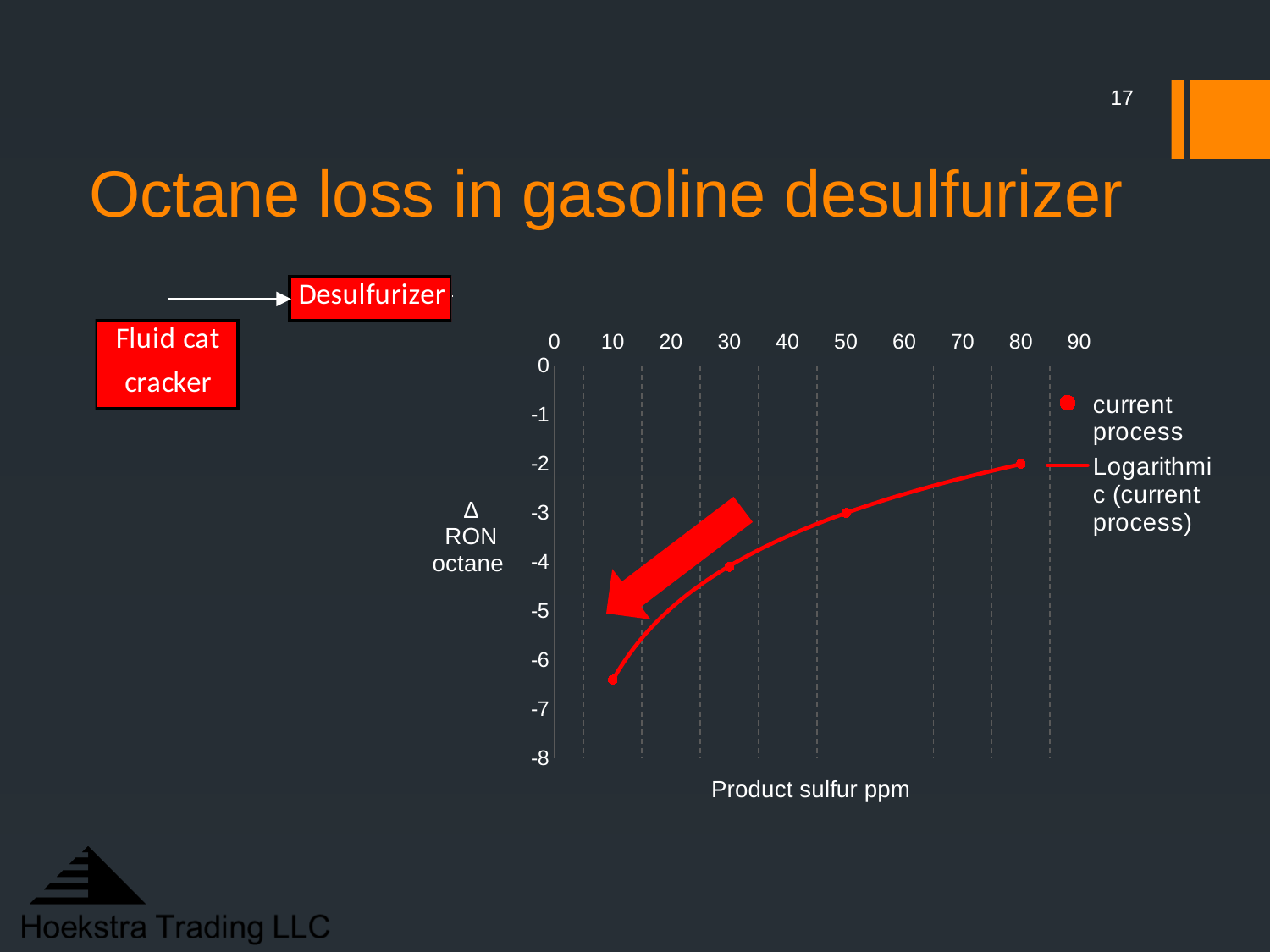
What kind of chart is shown on the slide? scatter chart Is the Δ RON octane value at 50 ppm product sulfur greater or less than -5? greater At which product sulfur level is the Δ RON octane value highest? 80 ppm Does the Δ RON octane value rise or fall as product sulfur ppm increases? rise What is the label on the y axis of the chart? Δ RON octane How many entries does the chart legend list? 2 Is the Δ RON octane value at 80 ppm product sulfur greater or less than -4? greater Which has the larger Δ RON octane value: the point at 10 ppm or the point at 80 ppm? 80 ppm What is the title of the x axis of the chart? Product sulfur ppm At which product sulfur level is the Δ RON octane value lowest? 10 ppm Is the Δ RON octane value at 10 ppm product sulfur greater or less than -5? less How many data points are plotted for the current process series? 4